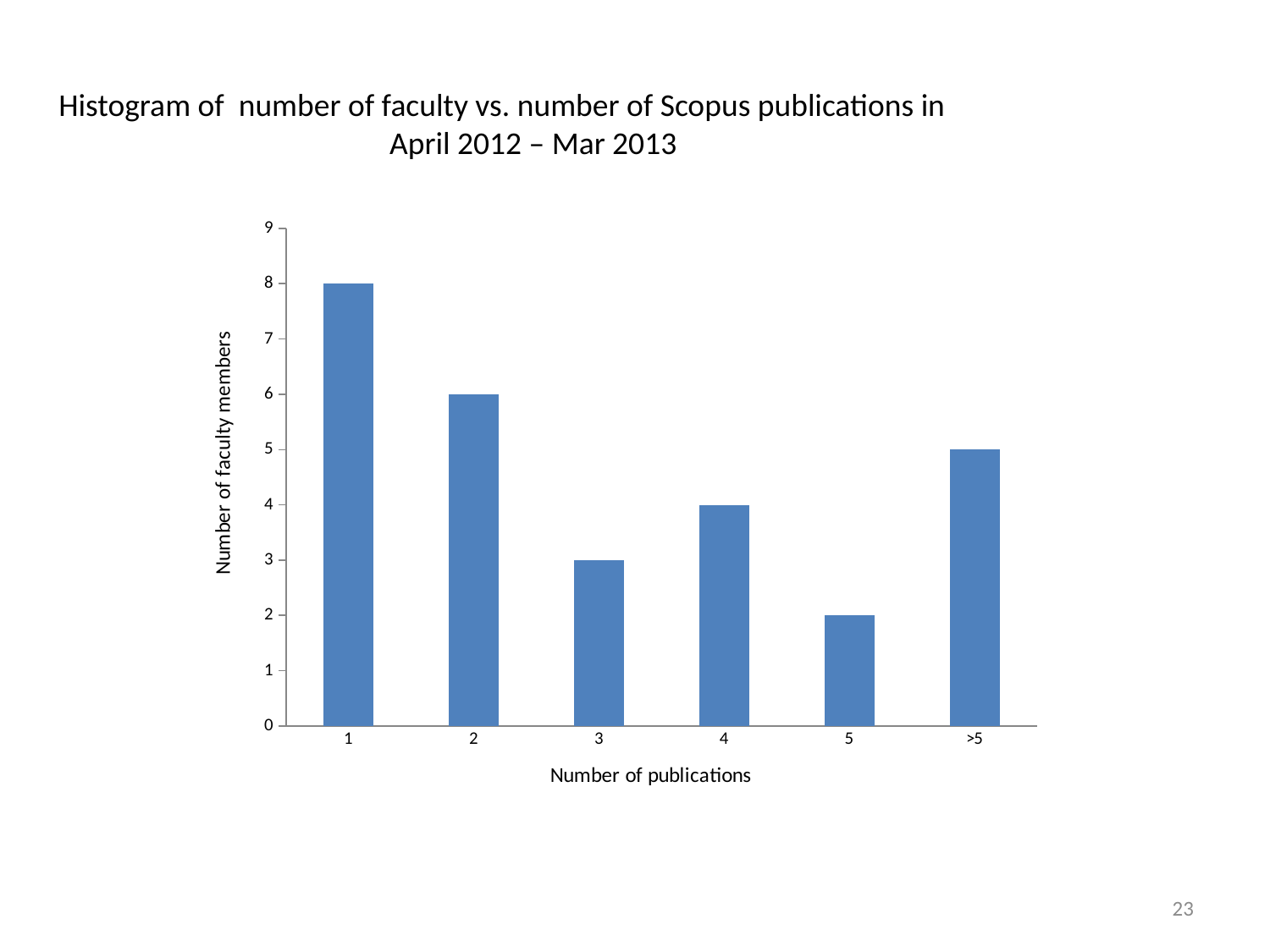
How many publication categories are shown on the x axis? 6 What is the label of the x axis? Number of publications What is the difference between the number of faculty members with 1 publication and those with 2 publications? 2 Which number of publications has the highest number of faculty members? 1 Which has more faculty members: 3 publications or 4 publications? 4 publications Is the number of faculty members with 5 publications greater or less than 3? less Which number of publications has the lowest number of faculty members? 5 How many faculty members have 2 publications? 6 What kind of chart is shown on the slide? bar chart How many faculty members have more than 5 (>5) publications? 5 How many faculty members have 1 publication? 8 What is the label of the y axis? Number of faculty members